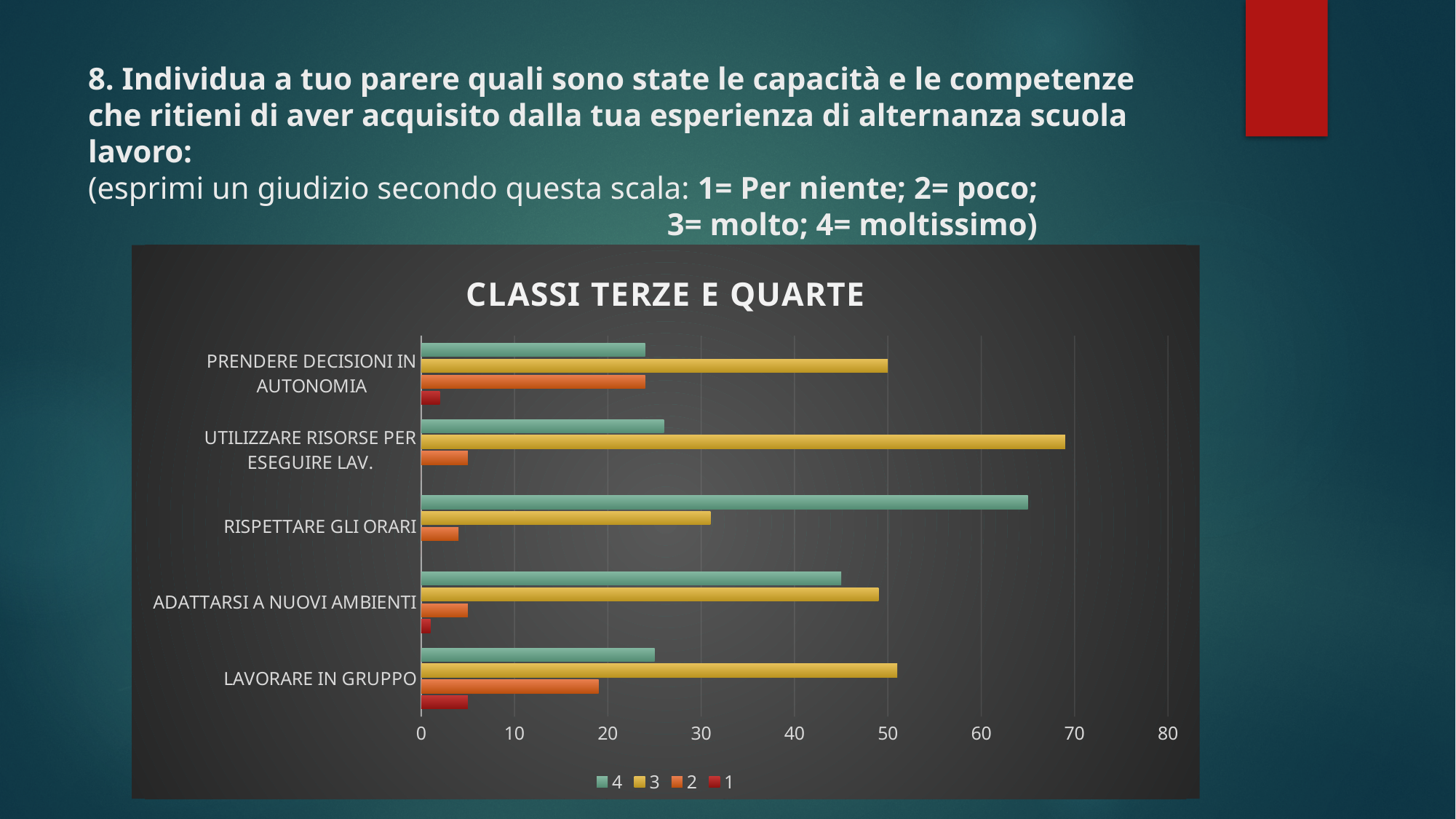
What is the title of the chart? CLASSI TERZE E QUARTE How many series does the legend list? 4 Which category has the highest value for series 2? PRENDERE DECISIONI IN AUTONOMIA Is the value of series 3 for PRENDERE DECISIONI IN AUTONOMIA greater or less than 40? greater Is the value of series 4 for RISPETTARE GLI ORARI greater or less than 60? greater What kind of chart is shown on the slide? bar chart For RISPETTARE GLI ORARI, which series has the larger value, 4 or 3? 4 Which category has the highest value for series 3? UTILIZZARE RISORSE PER ESEGUIRE LAV. Is the value of series 2 for LAVORARE IN GRUPPO greater or less than 10? greater How many categories are plotted on the chart? 5 Which category has the highest value for series 4? RISPETTARE GLI ORARI